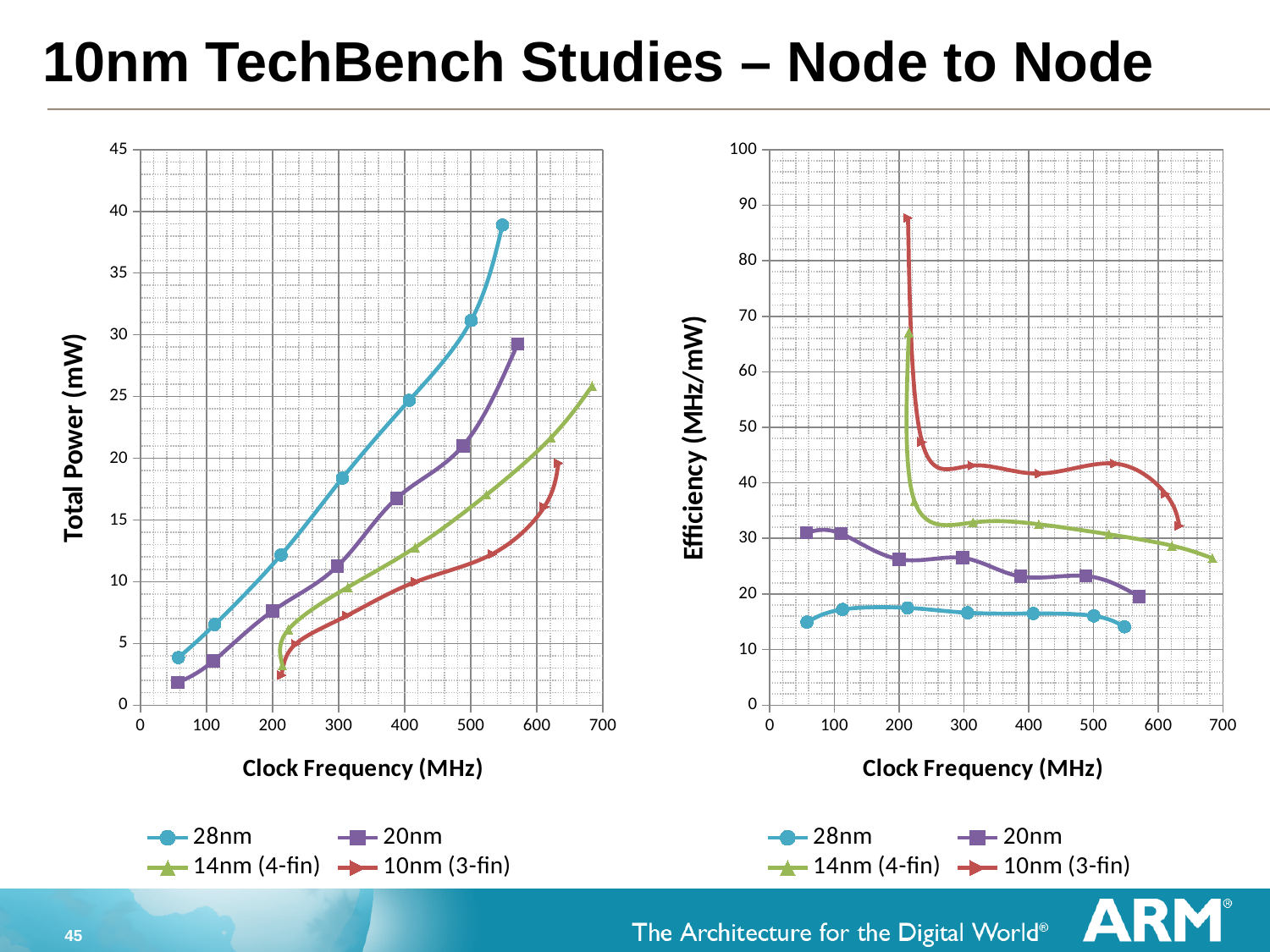
In the Efficiency (MHz/mW) chart on the right, is the highest value for 10nm (3-fin) greater or less than 80? greater In the Total Power (mW) chart on the left, is the highest 28nm value greater or less than 35? greater What is the x-axis label of the chart on the left? Clock Frequency (MHz) What is the y-axis label of the chart on the right? Efficiency (MHz/mW) In the Total Power (mW) chart on the left, does the 28nm series rise or fall as clock frequency increases? rises In the Total Power (mW) chart on the left, at 300 MHz, which series has the higher total power: 28nm or 20nm? 28nm What kind of chart is the Total Power (mW) chart on the left? line chart In the Total Power (mW) chart on the left, which series reaches the highest total power? 28nm How many series does the legend of the Efficiency (MHz/mW) chart on the right list? 4 In the Efficiency (MHz/mW) chart on the right, does the 20nm series generally rise or fall as clock frequency increases? falls In the Efficiency (MHz/mW) chart on the right, is the value for 28nm at 100 MHz greater or less than 20? less In the Efficiency (MHz/mW) chart on the right, which series has the lowest efficiency across the frequency range? 28nm